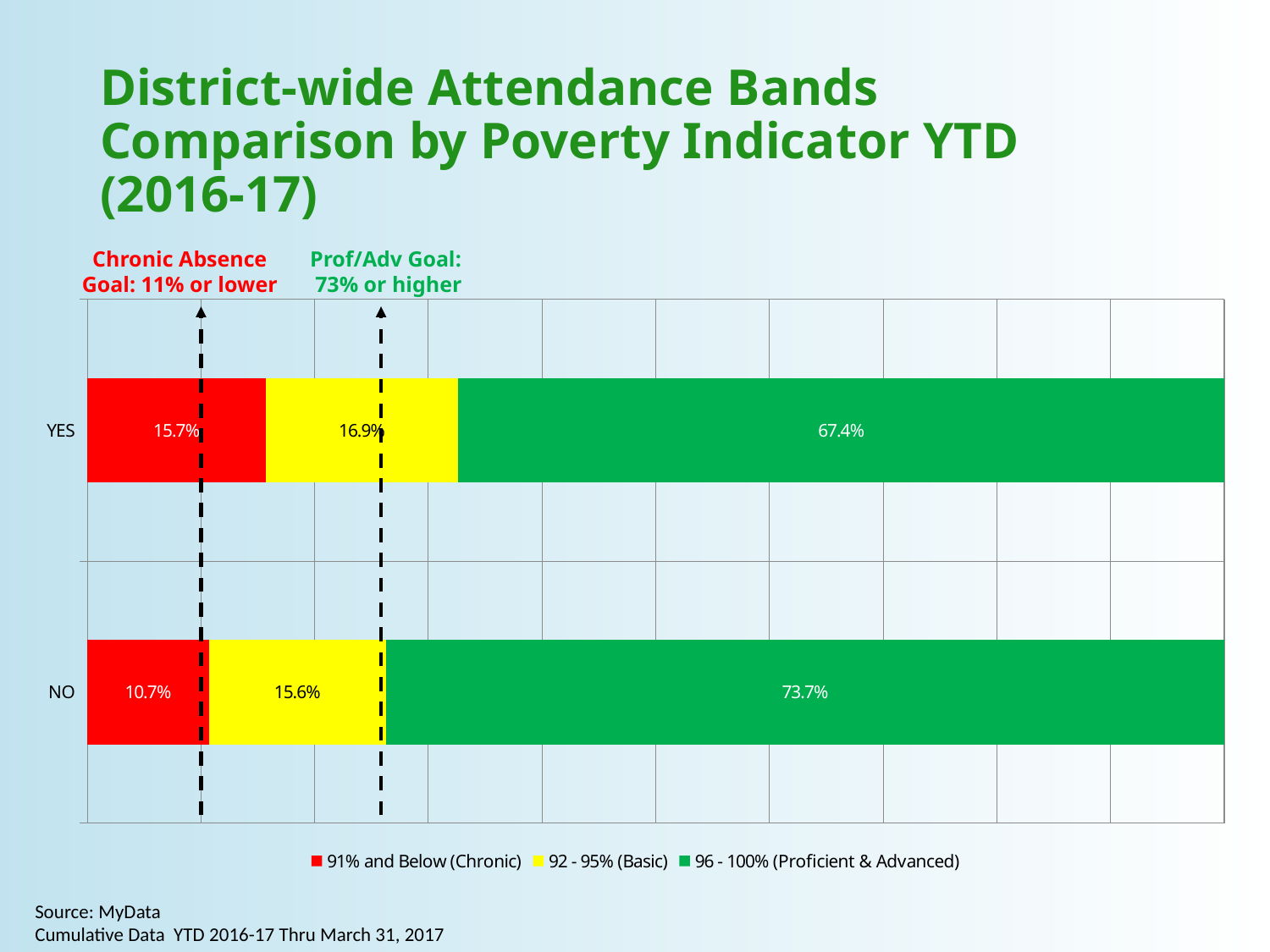
Which category has the higher 96 - 100% (Proficient & Advanced) value, YES or NO? NO How many categories are plotted on the chart? 2 What is the value of the 92 - 95% (Basic) band for the YES category? 16.9% How many series does the legend list? 3 What kind of chart is shown on the slide? Stacked bar chart What is the difference between the 91% and Below (Chronic) values for YES and NO? 5.0 percentage points What is the Chronic Absence goal stated above the chart? 11% or lower What is the value of the 91% and Below (Chronic) band for the YES category? 15.7% What is the value of the 96 - 100% (Proficient & Advanced) band for the NO category? 73.7% Which category has the lower 91% and Below (Chronic) value? NO What is the difference between the 96 - 100% (Proficient & Advanced) values for NO and YES? 6.3 percentage points What is the value of the 91% and Below (Chronic) band for the NO category? 10.7%